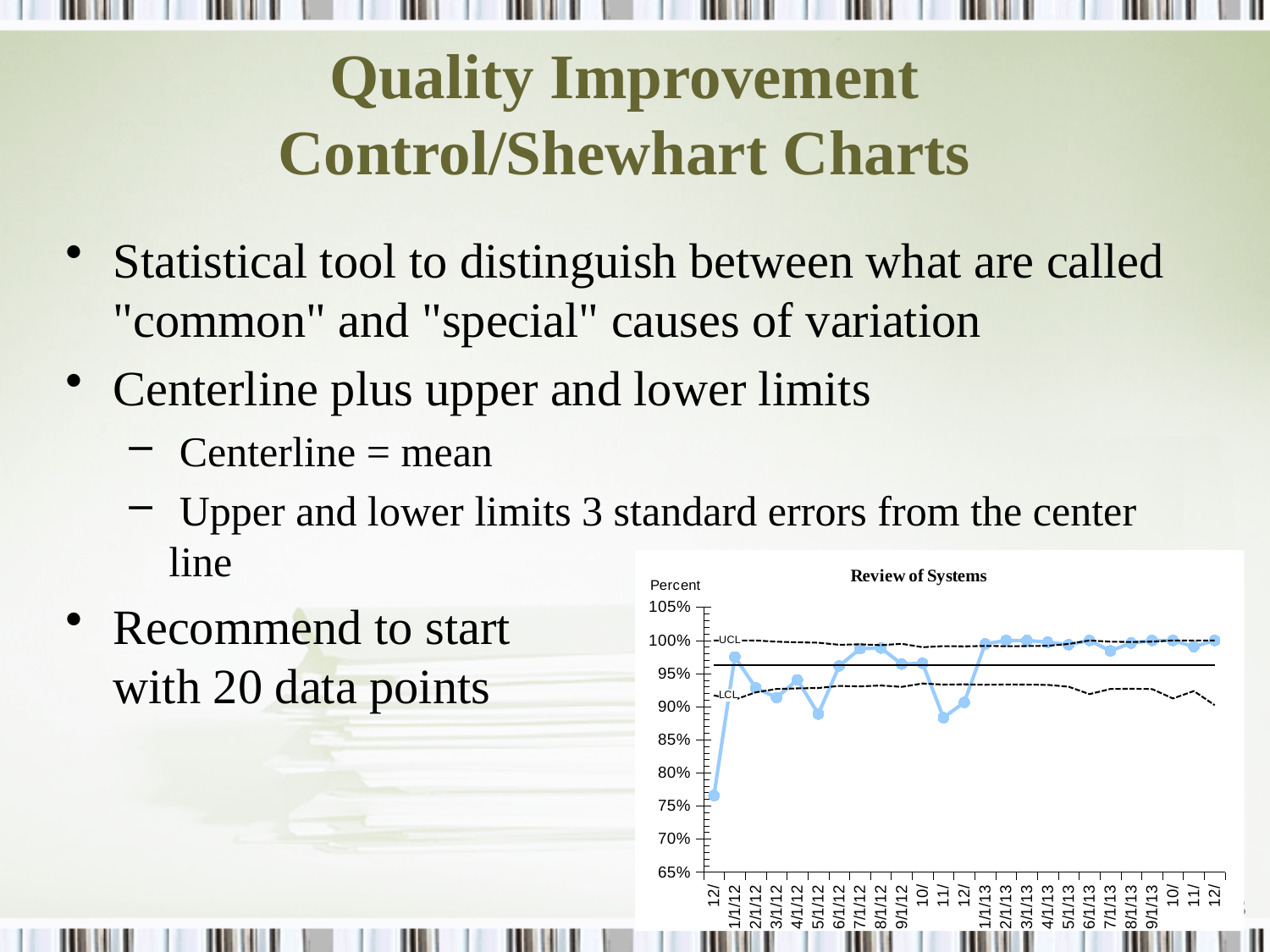
In the Review of Systems chart, which date has the lowest plotted value? 12/ (the first point) In the Review of Systems chart, is the value for 1/1/13 greater or less than 95%? greater In the Review of Systems chart, is the value for the first point (12/) greater or less than 80%? less What label is shown on the vertical axis of the Review of Systems chart? Percent In the Review of Systems chart, do the plotted values generally rise or fall from the first point to the last? rise In the Review of Systems chart, which is larger: the value for 11/ (2012) or the value for 1/1/13? 1/1/13 In the Review of Systems chart, is the value for 1/1/12 greater or less than 95%? greater How many data points are plotted in the Review of Systems chart? 25 What is the title of the chart on the slide? Review of Systems What kind of chart is the Review of Systems chart? line chart In the Review of Systems chart, which is larger: the value for the first point (12/) or the value for 1/1/12? 1/1/12